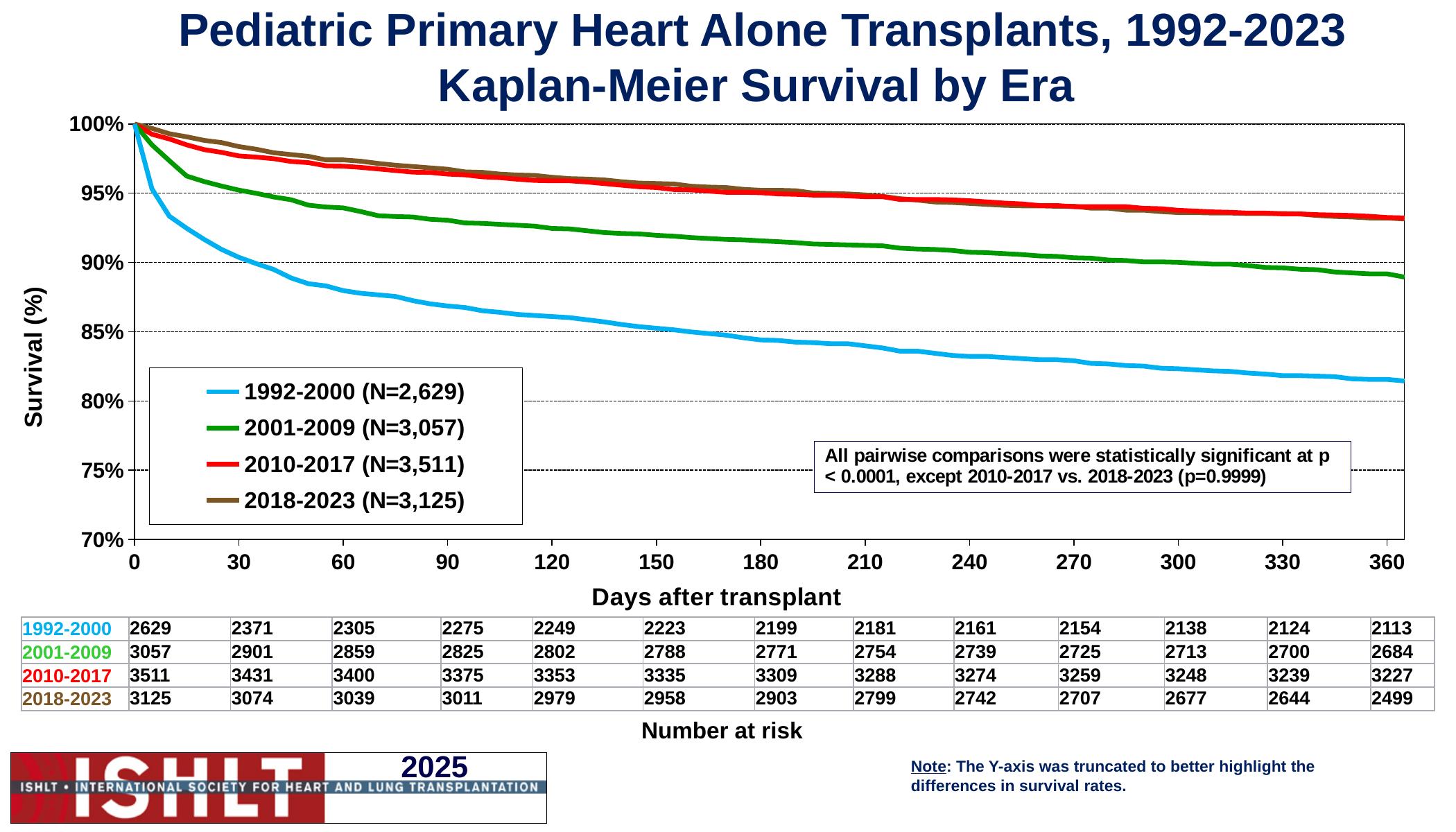
Is the survival for the 2001-2009 era at 360 days greater or less than 85%? greater At 180 days after transplant, which era has higher survival: 1992-2000 or 2001-2009? 2001-2009 What is the label of the x axis? Days after transplant Is the survival for the 2010-2017 era at 360 days greater or less than 90%? greater Do the survival curves rise or fall as days after transplant increase? fall Is the survival for the 1992-2000 era at 360 days greater or less than 85%? less What is the N shown in the legend for the 2010-2017 era? N=3,511 Which era has the lowest survival at 360 days after transplant? 1992-2000 According to the number at risk table, what is the difference between the number at risk for 1992-2000 at day 0 and at day 360? 516 How many eras (series) does the legend list? 4 According to the number at risk table, how many patients in the 2018-2023 era were at risk at day 360? 2499 What kind of chart is shown on the slide? line chart